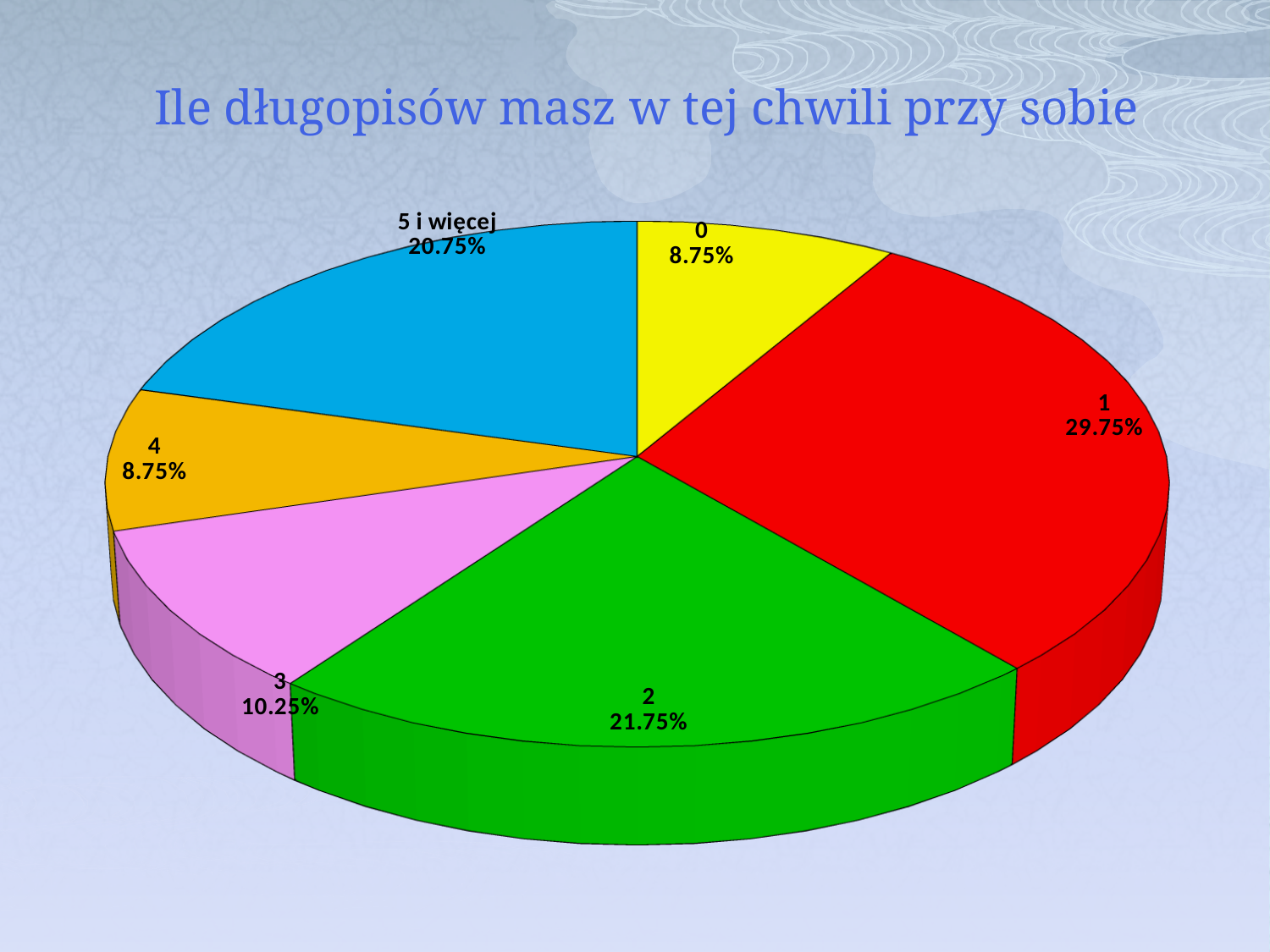
What is the difference between the percentages for category 1 and category 2? 8% What colour is the slice for category 2? Green What is the value shown for category 3? 10.25% What percentage of respondents have 1 pen with them? 29.75% What percentage is shown for category 0? 8.75% Which is larger, the slice for 2 or the slice for "5 i więcej"? 2 Which category has the largest slice of the pie? 1 What kind of chart is shown on the slide? Pie chart What is the title of the chart? Ile długopisów masz w tej chwili przy sobie How many categories are shown in the pie chart? 6 Which is larger, the slice for 3 or the slice for 4? 3 What share of the pie does the "5 i więcej" slice represent? 20.75%